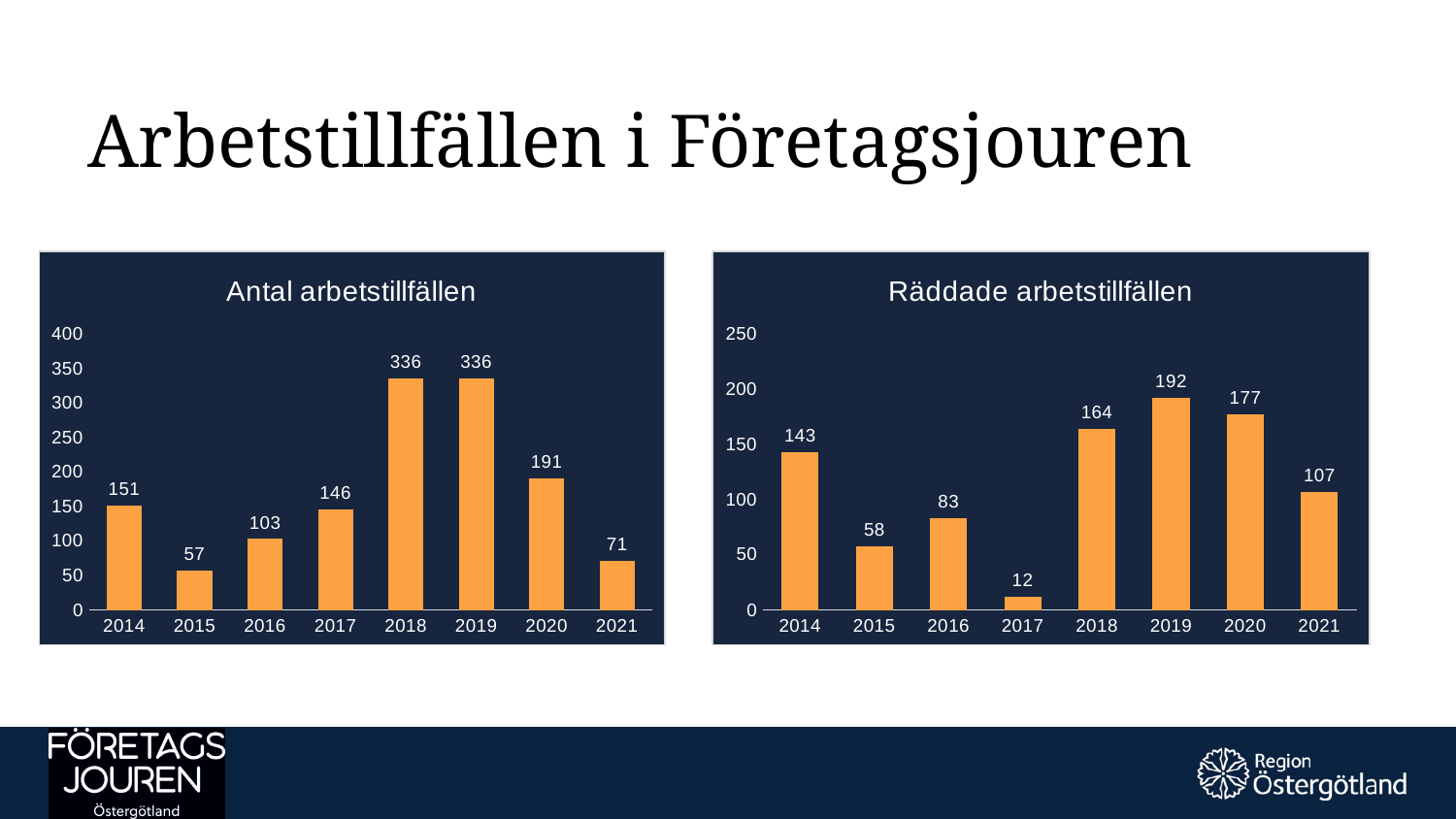
In the 'Antal arbetstillfällen' chart, which year has the lowest value? 2015 In the 'Antal arbetstillfällen' chart, which is larger, the value for 2017 or the value for 2016? 2017 In the 'Räddade arbetstillfällen' chart, what is the difference between the values for 2018 and 2016? 81 In the 'Antal arbetstillfällen' chart, do the values rise or fall from 2019 to 2021? fall In the 'Räddade arbetstillfällen' chart, what is the value for 2019? 192 In the 'Antal arbetstillfällen' chart, what is the value for 2014? 151 In the 'Räddade arbetstillfällen' chart, which year has the lowest value? 2017 In the 'Räddade arbetstillfällen' chart, is the value for 2020 greater or less than 150? greater In the 'Räddade arbetstillfällen' chart, which year has the highest value? 2019 How many years are shown on the x axis of the 'Antal arbetstillfällen' chart? 8 In the 'Antal arbetstillfällen' chart, what is the difference between the values for 2020 and 2021? 120 What kind of chart is the 'Räddade arbetstillfällen' chart? bar chart